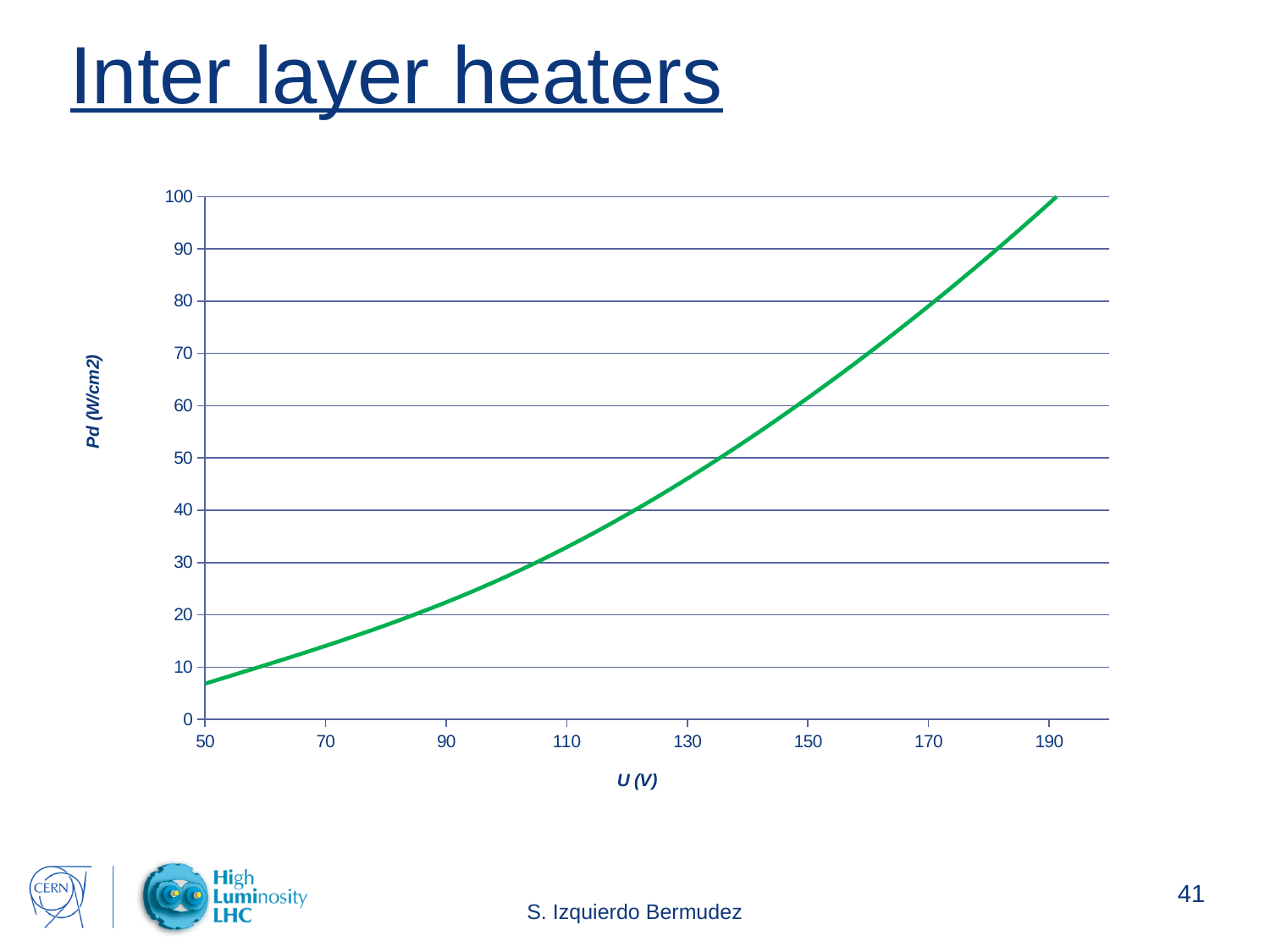
What kind of chart is shown on the slide? line chart Does Pd rise or fall as U increases along the x axis? rise What is the label of the horizontal axis? U (V) Is the value of Pd at U = 190 V greater or less than 90? greater What is the label of the vertical axis? Pd (W/cm2) Is the value of Pd at U = 130 V greater or less than 50? less Is the value of Pd at U = 50 V greater or less than 10? less How many lines are plotted on the chart? 1 Is Pd larger at U = 90 V or at U = 170 V? U = 170 V